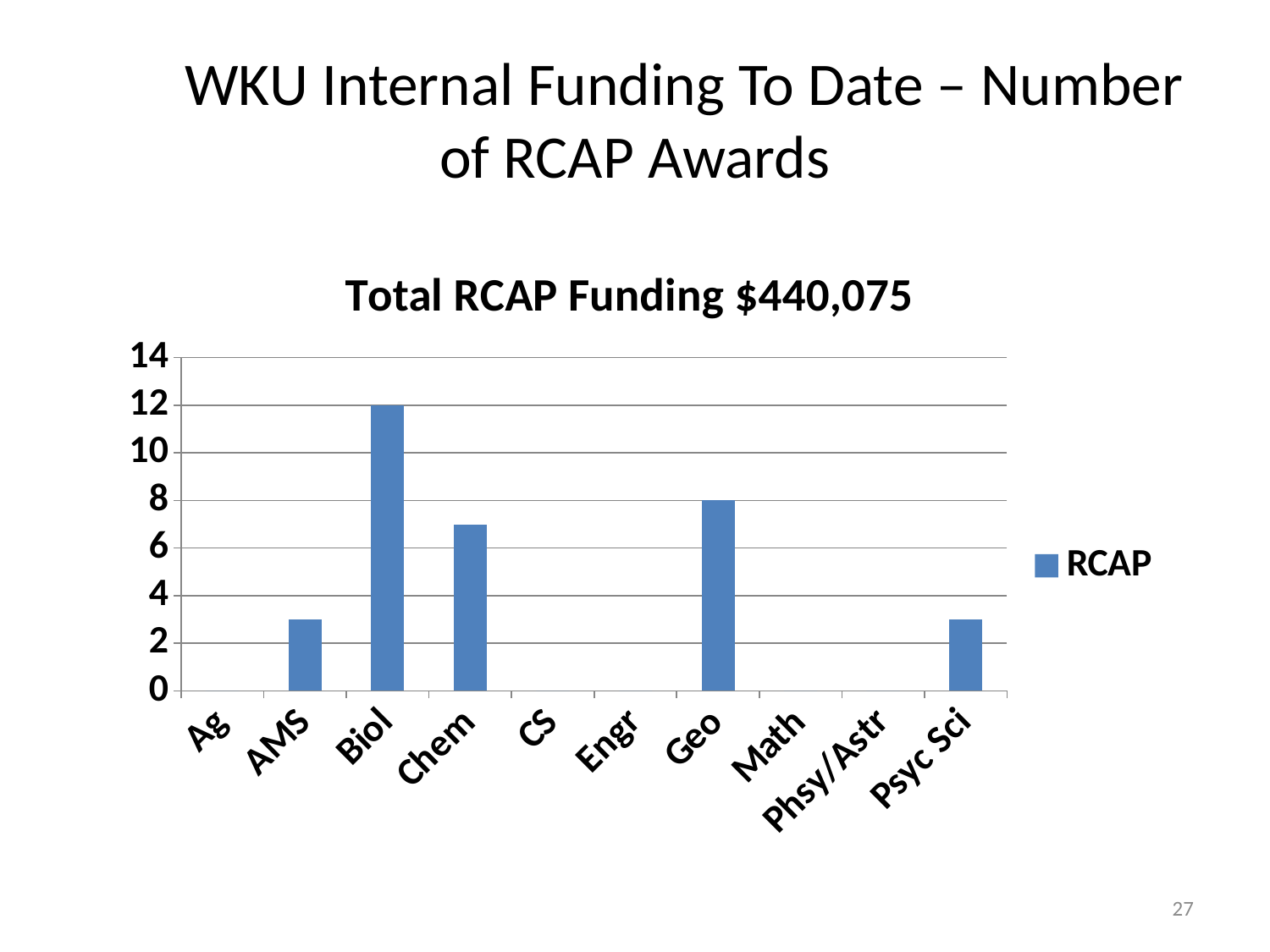
How many series does the legend list? 1 Which category has the highest number of RCAP awards? Biol What is the value for Geo? 8 Is the value for AMS greater or less than 4? less What is the value for Biol? 12 What type of chart is shown on the slide? bar chart What is the difference between the values for Biol and Geo? 4 How many categories are shown on the x axis? 10 Which is larger, the value for Chem or the value for Geo? Geo What is the name of the series shown in the legend? RCAP What is the title of the chart? Total RCAP Funding $440,075 Is the value for Chem greater or less than 6? greater